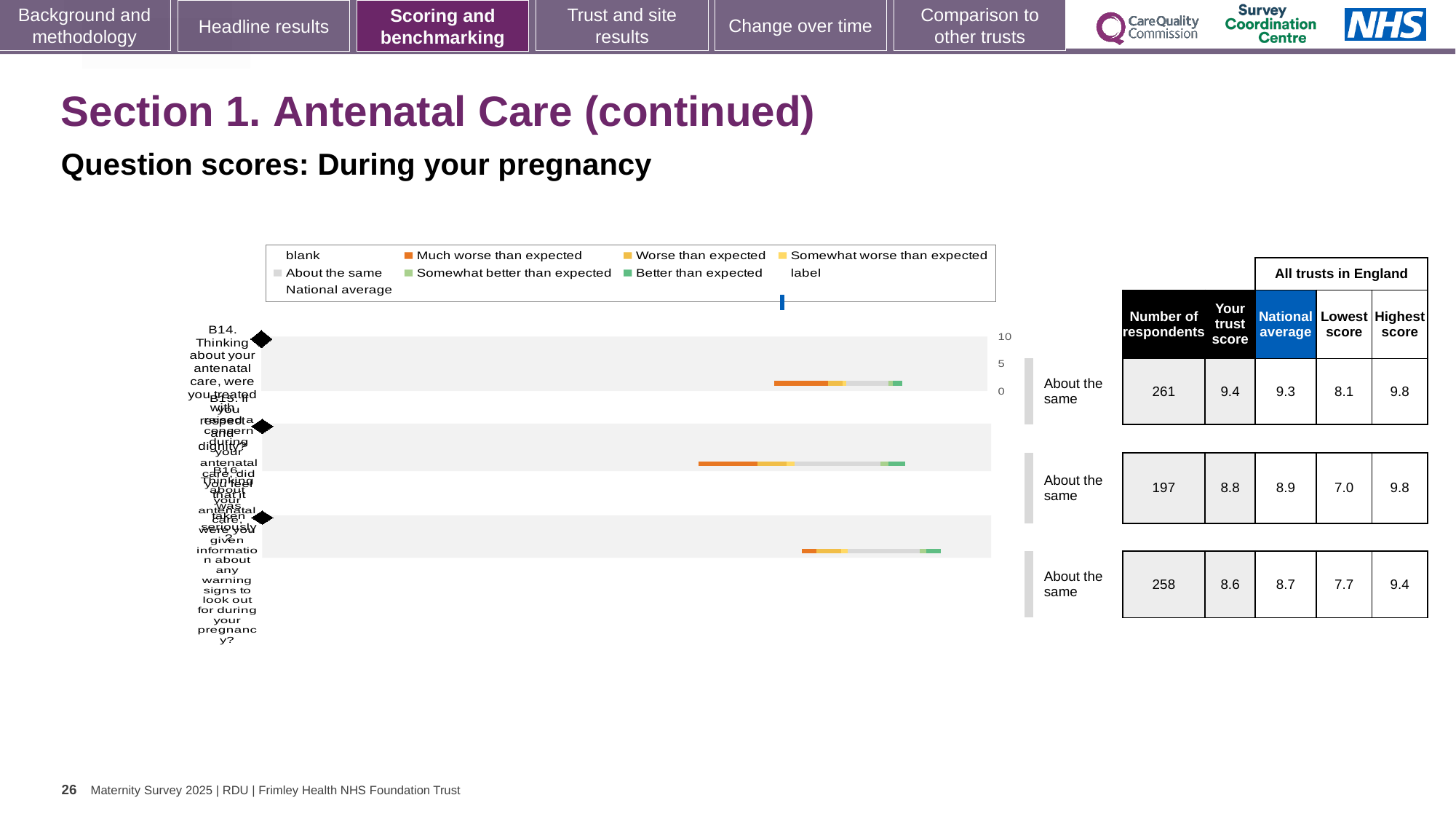
In the table next to the chart, which row has the lowest trust score? the third row, 8.6 In the table next to the chart, what is the number of respondents for the first row (B14)? 261 In the table next to the chart, what is the national average for the second row? 8.9 In the table next to the chart, which row has the highest number of respondents? the first row (B14), 261 In the table next to the chart, what is the difference between the highest score and the lowest score for the second row? 2.8 In the table next to the chart, what is the trust score for the first row (B14)? 9.4 In the table next to the chart, is the trust score for the first row (B14) larger or smaller than its national average? larger What kind of chart is shown on the slide? bar chart Which legend entry is shown in orange in the chart legend? Much worse than expected In the table next to the chart, what is the lowest score for the third row? 7.7 How many bars (question rows) are plotted in the chart? 3 What is the highest tick value shown on the chart's axis? 10